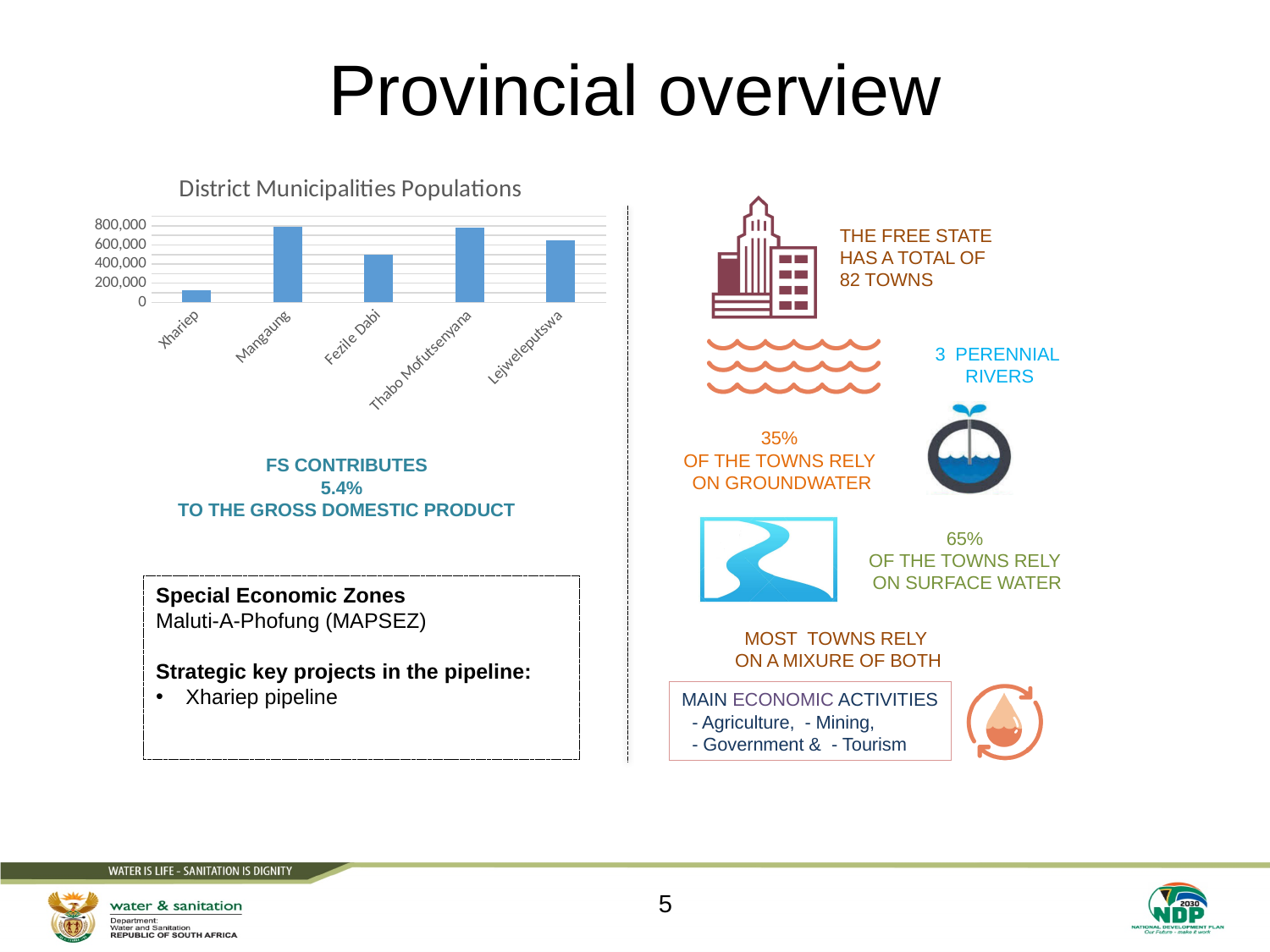
Which has the larger population in the chart, Mangaung or Fezile Dabi? Mangaung What is the title of the chart on the slide? District Municipalities Populations What is the highest value shown on the vertical axis of the chart? 800,000 Which has the larger population in the chart, Lejweleputswa or Fezile Dabi? Lejweleputswa Is the population value for Thabo Mofutsenyana greater or less than 600,000? greater How many district municipalities are shown in the chart? 5 Which district municipality has the lowest population in the chart? Xhariep Is the population value for Fezile Dabi greater or less than 400,000? greater Is the population value for Xhariep greater or less than 200,000? less What kind of chart is used to show the district municipalities populations? bar chart